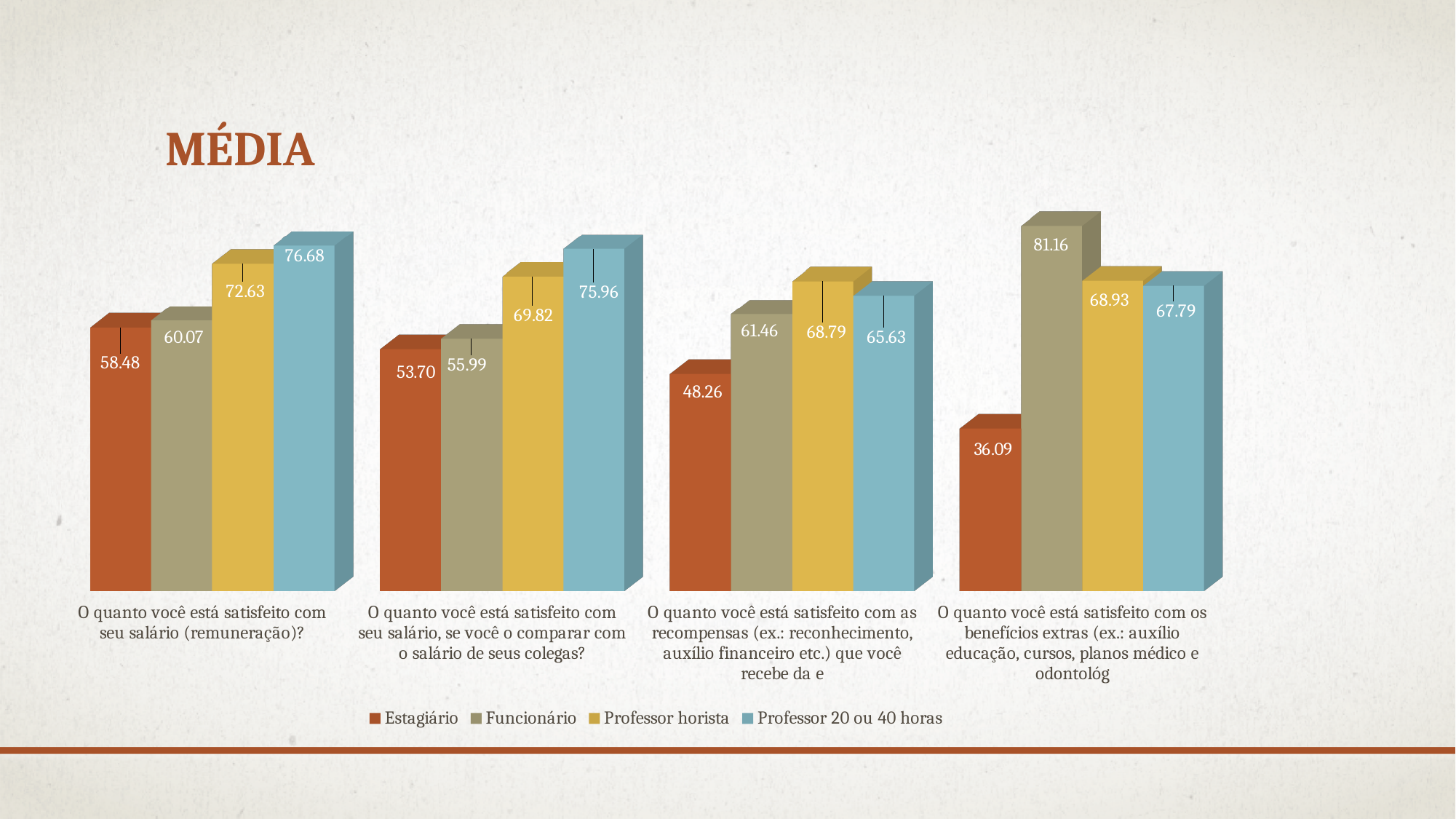
In the category about recompensas, which is larger: the Professor horista value or the Professor 20 ou 40 horas value? Professor horista How many categories are shown on the x axis of the chart? 4 What kind of chart is shown on the slide? Bar chart How many series does the legend list? 4 What is the value for Professor horista in the category about recompensas (reconhecimento, auxílio financeiro etc.)? 68.79 What is the difference between the Professor 20 ou 40 horas value and the Estagiário value in the category 'O quanto você está satisfeito com seu salário (remuneração)?' 18.20 Which series has the highest value in the category about benefícios extras? Funcionário What is the value for Estagiário in the category 'O quanto você está satisfeito com seu salário (remuneração)?' 58.48 Which series has the lowest value in the category about recompensas? Estagiário What is the title of the chart? MÉDIA What is the value for Funcionário in the category about benefícios extras? 81.16 What is the value for Professor 20 ou 40 horas in the category about comparing your salary with that of your colleagues? 75.96